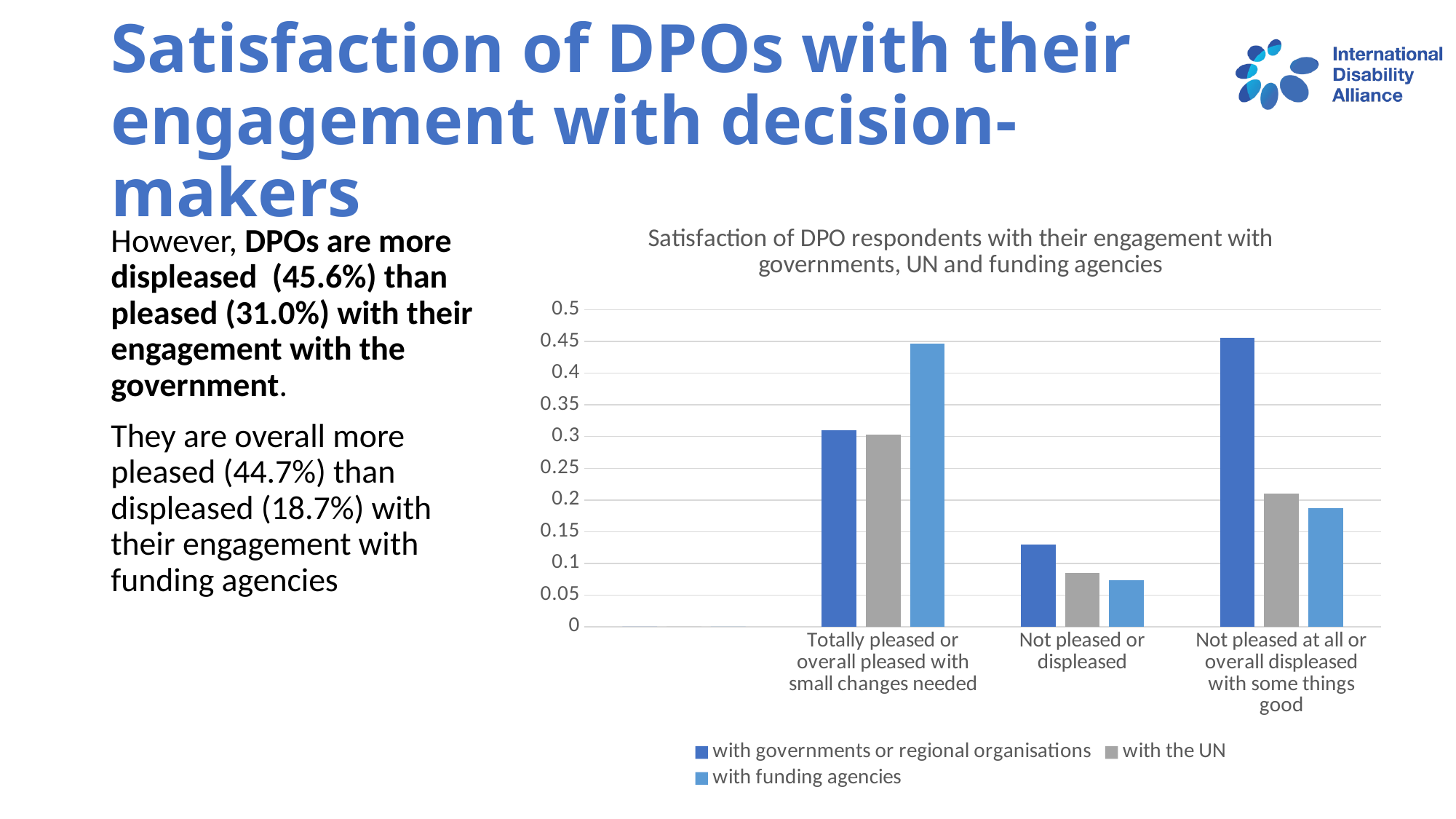
How many series does the chart legend list? 3 Is the value for 'with governments or regional organisations' in the 'Not pleased at all or overall displeased with some things good' category greater or less than 0.4? greater Is the value for 'with governments or regional organisations' in the 'Not pleased or displeased' category greater or less than 0.1? greater Is the value for 'with the UN' in the 'Not pleased or displeased' category greater or less than 0.1? less What is the title of the chart? Satisfaction of DPO respondents with their engagement with governments, UN and funding agencies Which series has the highest bar in the 'Totally pleased or overall pleased with small changes needed' category? with funding agencies What kind of chart is shown on the slide? Bar chart Which series has the highest bar in the 'Not pleased at all or overall displeased with some things good' category? with governments or regional organisations Which series is shown in grey in the chart? with the UN In the 'Not pleased at all or overall displeased with some things good' category, which is larger: the value for 'with governments or regional organisations' or the value for 'with funding agencies'? with governments or regional organisations